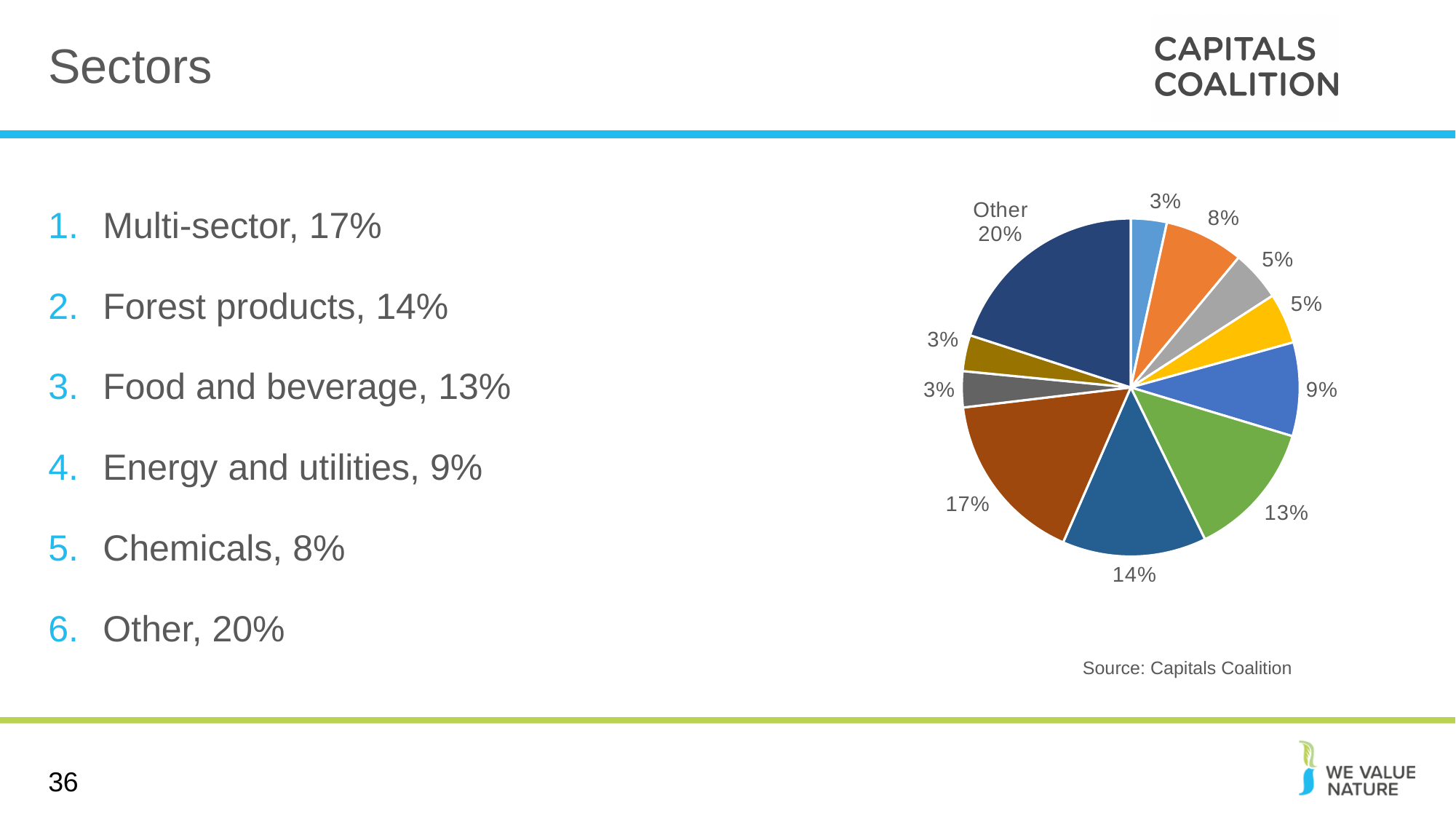
How many slices does the pie chart have? 11 How many slices of the pie chart are labelled 5%? 2 Which slice of the pie chart is the largest? Other, 20% What source is cited below the pie chart? Capitals Coalition What is the difference between the Multi-sector share and the Forest products share listed on the slide? 3% What share of the pie does the 'Other' slice represent? 20% Which slice of the pie chart is labelled with a category name rather than only a percentage? Other What is the smallest share shown on the pie chart? 3% What is the difference between the 'Other' slice (20%) and the 17% slice? 3% How many slices of the pie chart are labelled 3%? 3 According to the slide, which is larger: the share for Forest products or the share for Food and beverage? Forest products What kind of chart is shown on the slide? pie chart